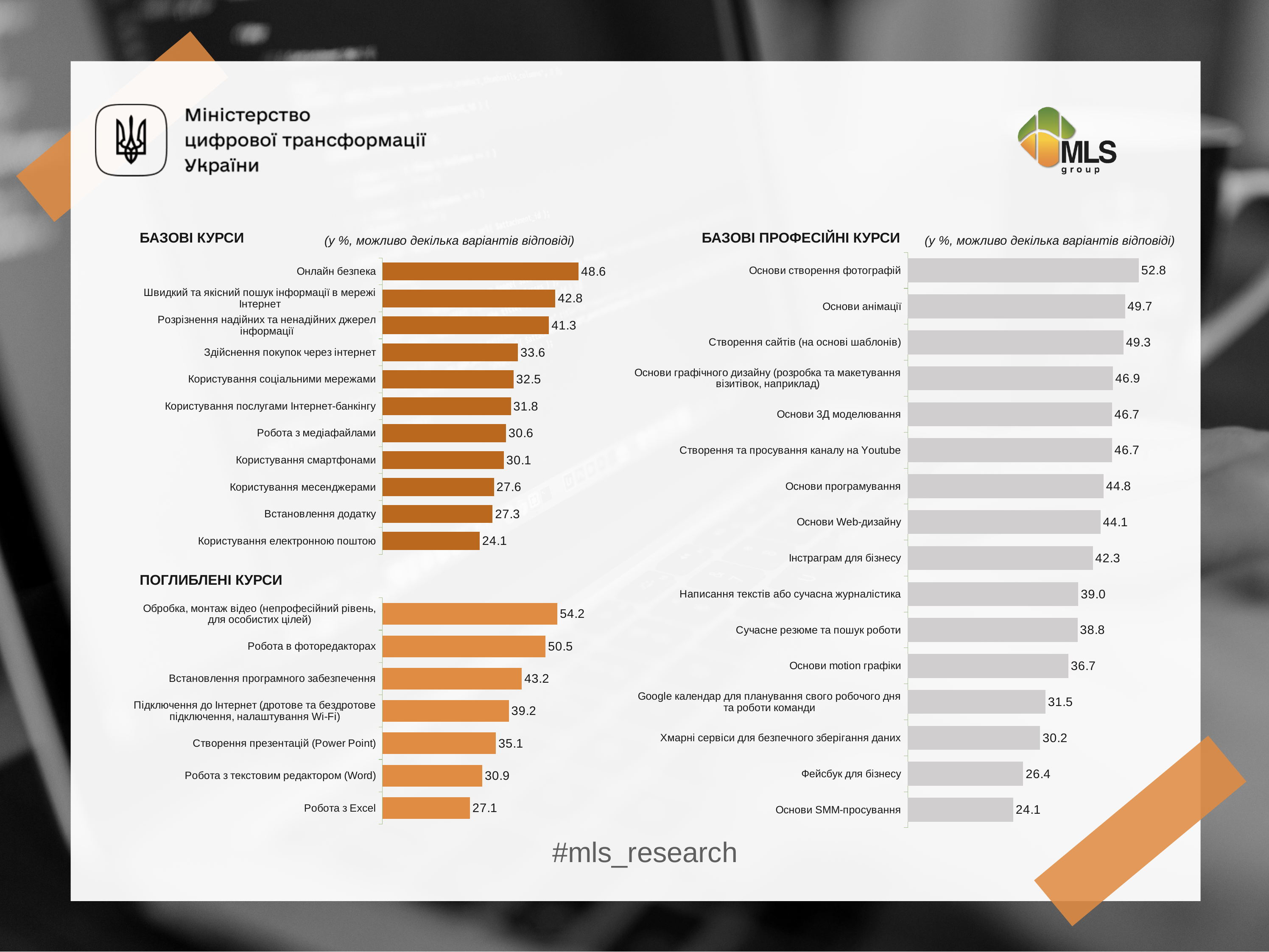
In the "БАЗОВІ ПРОФЕСІЙНІ КУРСИ" chart, what is the value for "Основи програмування"? 44.8 In the "БАЗОВІ КУРСИ" chart, which category has the lowest value? Користування електронною поштою In the "БАЗОВІ КУРСИ" chart, what is the value for "Онлайн безпека"? 48.6 In the "БАЗОВІ ПРОФЕСІЙНІ КУРСИ" chart, what is the difference between "Основи створення фотографій" and "Основи SMM-просування"? 28.7 In the "БАЗОВІ КУРСИ" chart, how many categories are shown? 11 In the "ПОГЛИБЛЕНІ КУРСИ" chart, how many categories are shown? 7 In the "БАЗОВІ КУРСИ" chart, what is the difference between "Онлайн безпека" and "Здійснення покупок через інтернет"? 15.0 In the "ПОГЛИБЛЕНІ КУРСИ" chart, what is the value for "Робота в фоторедакторах"? 50.5 What type of chart is the "БАЗОВІ ПРОФЕСІЙНІ КУРСИ" chart? Bar chart In the "БАЗОВІ ПРОФЕСІЙНІ КУРСИ" chart, which category has the highest value? Основи створення фотографій In the "ПОГЛИБЛЕНІ КУРСИ" chart, which category has the highest value? Обробка, монтаж відео (непрофесійний рівень, для особистих цілей) In the "ПОГЛИБЛЕНІ КУРСИ" chart, which is larger: "Створення презентацій (Power Point)" or "Робота з Excel"? Створення презентацій (Power Point)